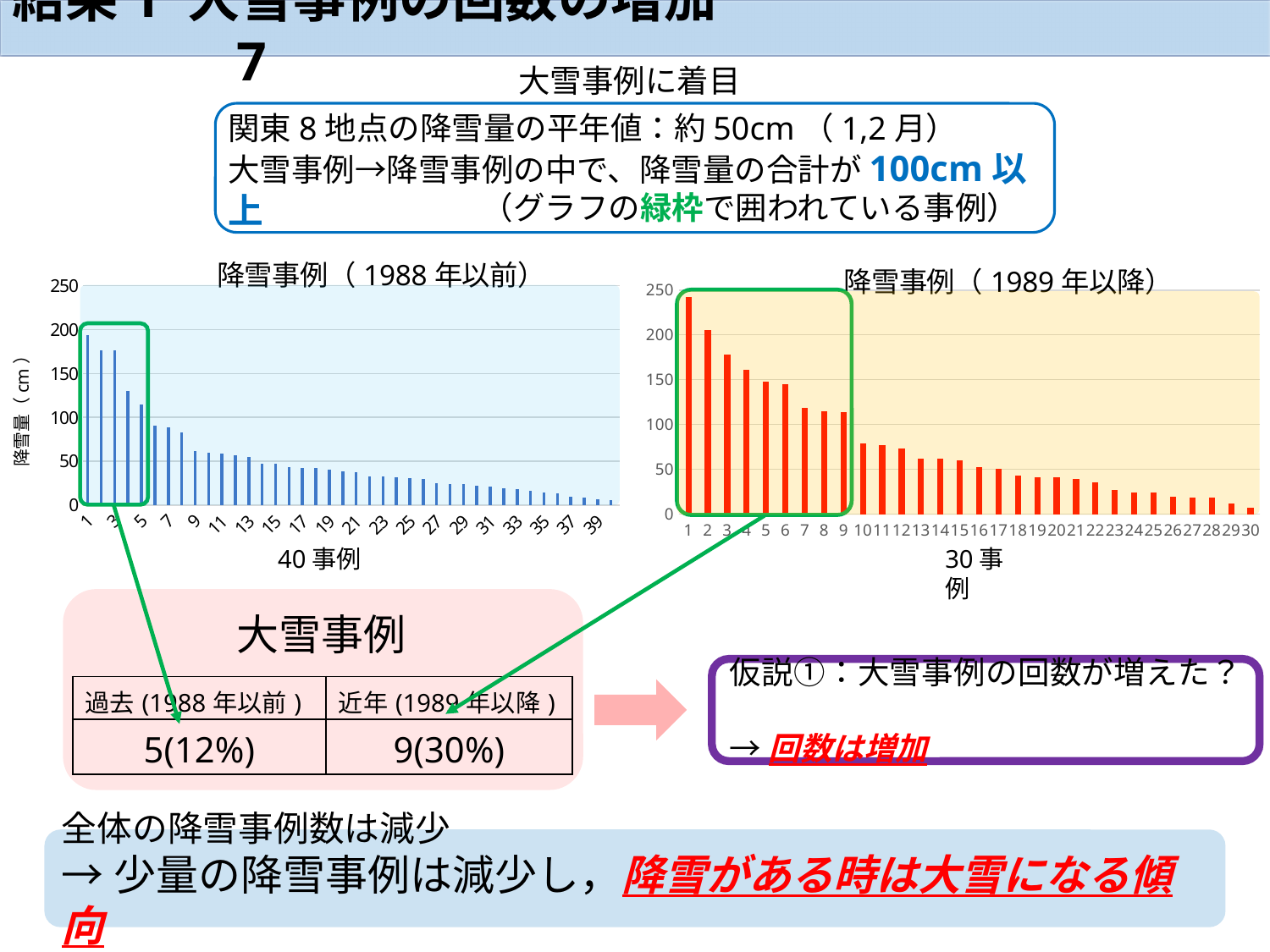
In the right chart titled 降雪事例（1989年以降）, which case number has the highest snowfall? 1 In the right chart titled 降雪事例（1989年以降）, how many cases (bars) are plotted? 30 What colour are the bars in the right chart titled 降雪事例（1989年以降）? red In the left chart titled 降雪事例（1988年以前）, is the value for case 1 greater or less than 150? greater In the left chart titled 降雪事例（1988年以前）, do the values rise or fall as the case number increases along the x axis? fall In the right chart titled 降雪事例（1989年以降）, which is larger, the value for case 1 or the value for case 2? case 1 In the right chart titled 降雪事例（1989年以降）, is the value for case 10 greater or less than 100? less In the left chart titled 降雪事例（1988年以前）, how many cases (bars) are plotted? 40 In the left chart titled 降雪事例（1988年以前）, which case number has the lowest snowfall? 40 What is the y-axis label of the left chart titled 降雪事例（1988年以前）? 降雪量（cm） What kind of chart is the left chart titled 降雪事例（1988年以前）? bar chart In the right chart titled 降雪事例（1989年以降）, is the value for case 1 greater or less than 200? greater